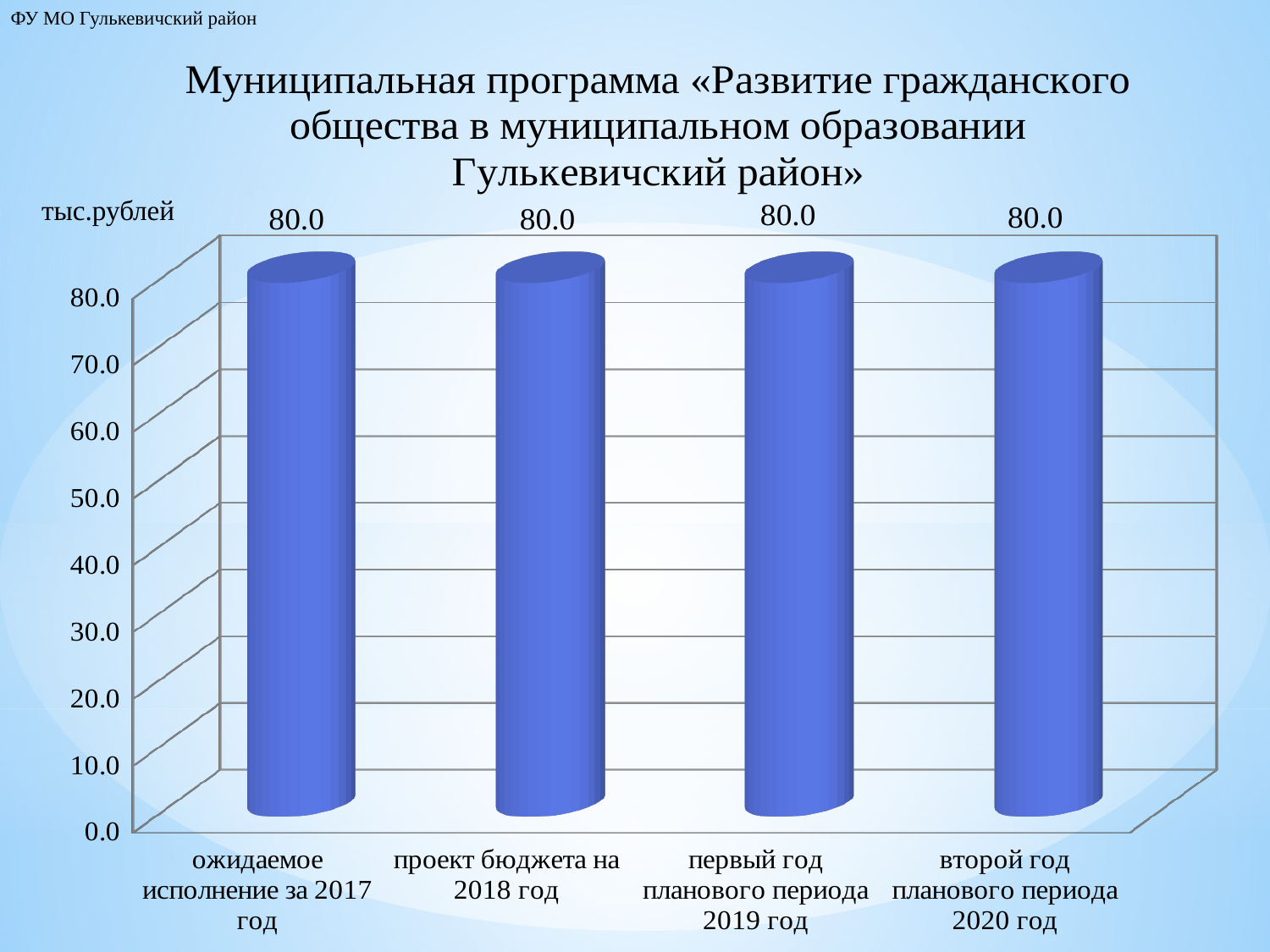
What is the value for «ожидаемое исполнение за 2017 год»? 80.0 What is the difference between the value for 2018 год and the value for 2017 год? 0.0 Which is larger: the value for 2019 год or the value for 2020 год? they are equal What is the value for «второй год планового периода 2020 год»? 80.0 What is the value for «проект бюджета на 2018 год»? 80.0 Is the value for «второй год планового периода 2020 год» greater or less than 70.0? greater What kind of chart is shown on the slide? bar chart Do the values rise, fall, or stay the same from 2017 to 2020? stay the same How many categories (bars) are shown in the chart? 4 What is the value for «первый год планового периода 2019 год»? 80.0 In what units are the values on the chart expressed? тыс.рублей Is the value for «проект бюджета на 2018 год» greater or less than 50.0? greater